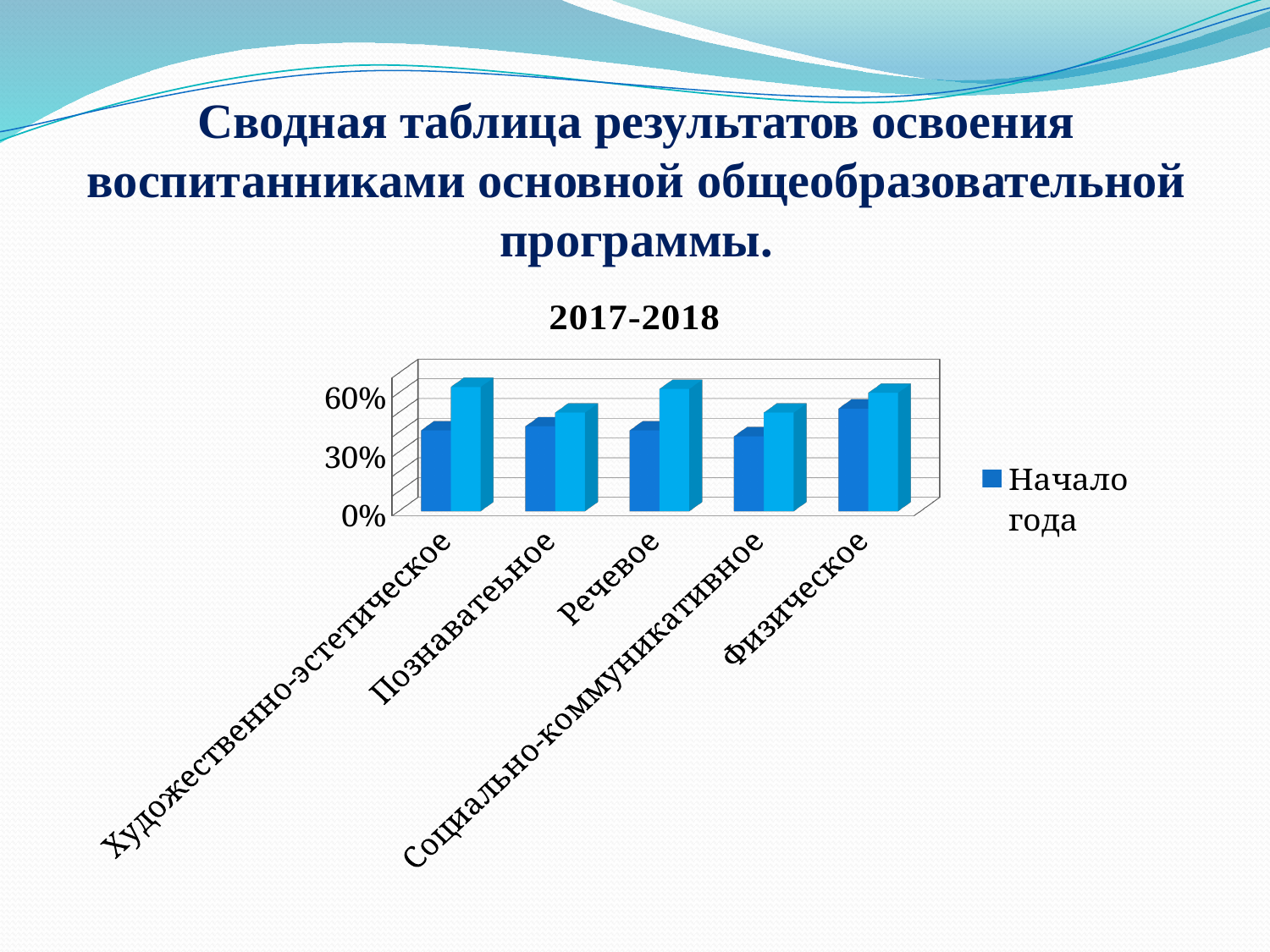
What is the title of the chart? 2017-2018 For Художественно-эстетическое, which bar is taller: the Начало года bar or the lighter blue bar? the lighter blue bar Is the Начало года value for Физическое greater or less than 30%? greater What series name is shown in the chart's legend? Начало года How many categories are shown on the x axis of the chart? 5 Which is larger for the Начало года series: Физическое or Социально-коммуникативное? Физическое Is the Начало года value for Речевое greater or less than 30%? greater Which category has the highest value for the Начало года series? Физическое Is the Начало года value for Социально-коммуникативное greater or less than 60%? less How many series does the chart's legend list? 1 What kind of chart is shown on the slide? bar chart